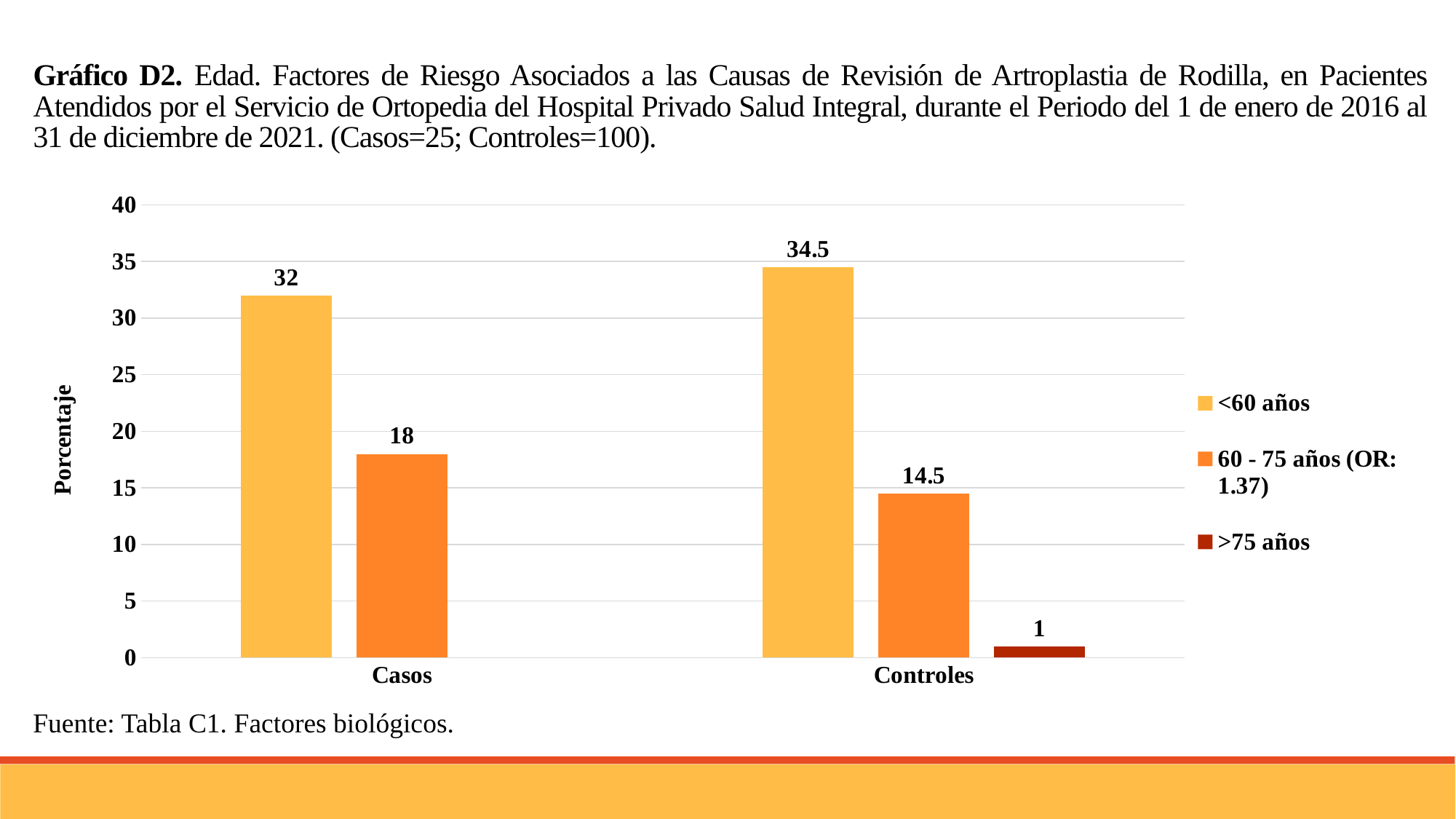
What kind of chart is shown on the slide? Bar chart What is the value for '<60 años' in the Casos group? 32 What is the value for '<60 años' in the Controles group? 34.5 What is the value for '60 - 75 años (OR: 1.37)' in the Controles group? 14.5 Which is larger: the '<60 años' value for Casos or for Controles? Controles Is the value for '60 - 75 años (OR: 1.37)' in the Casos group greater or less than 20? less How many categories are shown on the x axis? 2 What is the value for '>75 años' in the Controles group? 1 How many series does the legend list? 3 Which series has the highest value in the Controles group? <60 años Which series has the lowest value in the Controles group? >75 años What is the difference between the '<60 años' value and the '60 - 75 años (OR: 1.37)' value in the Casos group? 14